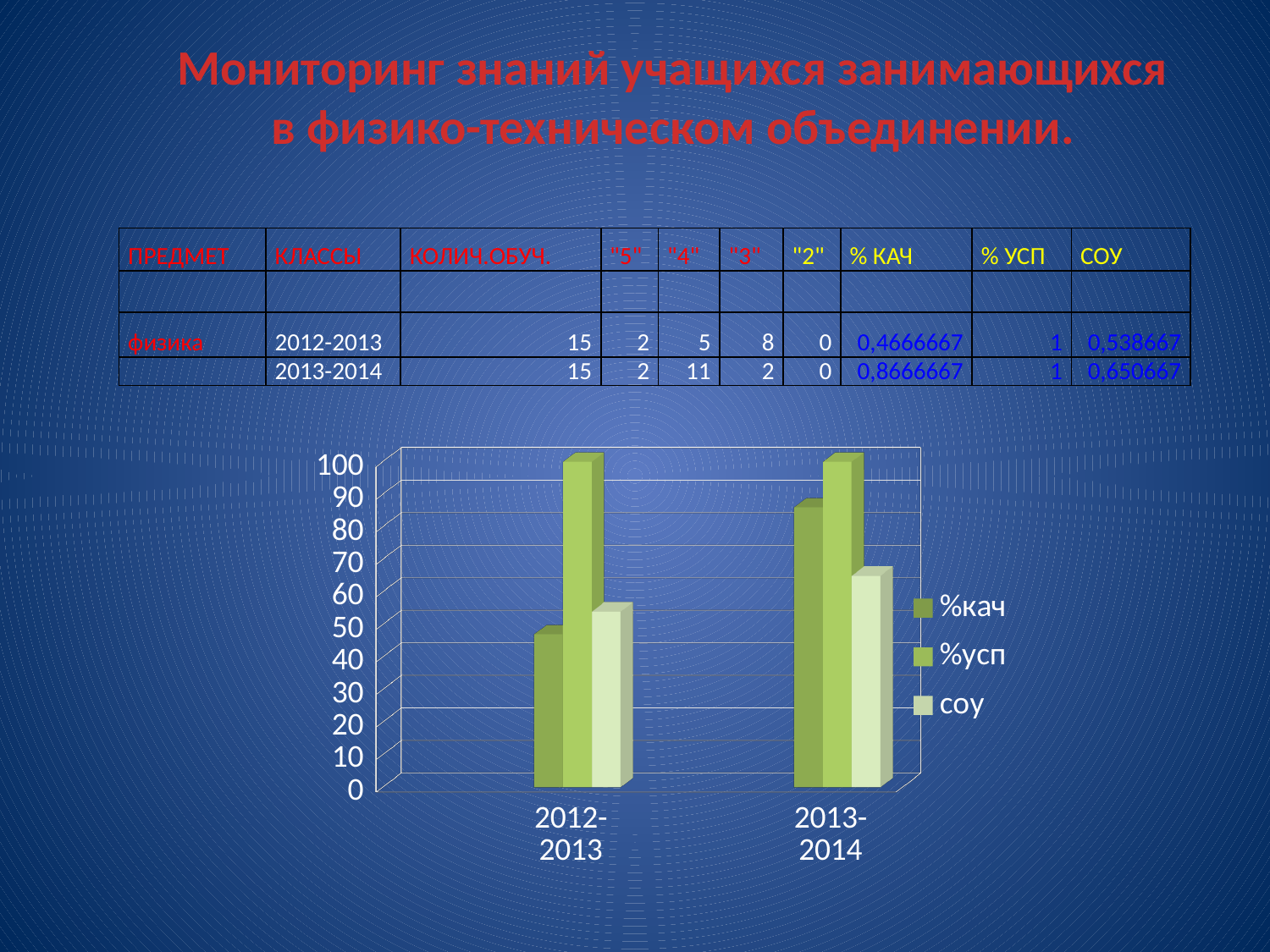
Is the value of соу for 2013-2014 greater or less than 70? less Which is larger, %кач for 2012-2013 or %кач for 2013-2014? 2013-2014 What are the series names listed in the chart legend? %кач, %усп, соу What kind of chart is shown on the slide? bar chart How many categories are shown on the x axis of the chart? 2 Is the value of %кач for 2013-2014 greater or less than 80? greater Is the value of соу for 2012-2013 greater or less than 50? greater Which series has the highest bar for 2012-2013? %усп Does the value of соу rise or fall from 2012-2013 to 2013-2014? rise How many series does the chart legend list? 3